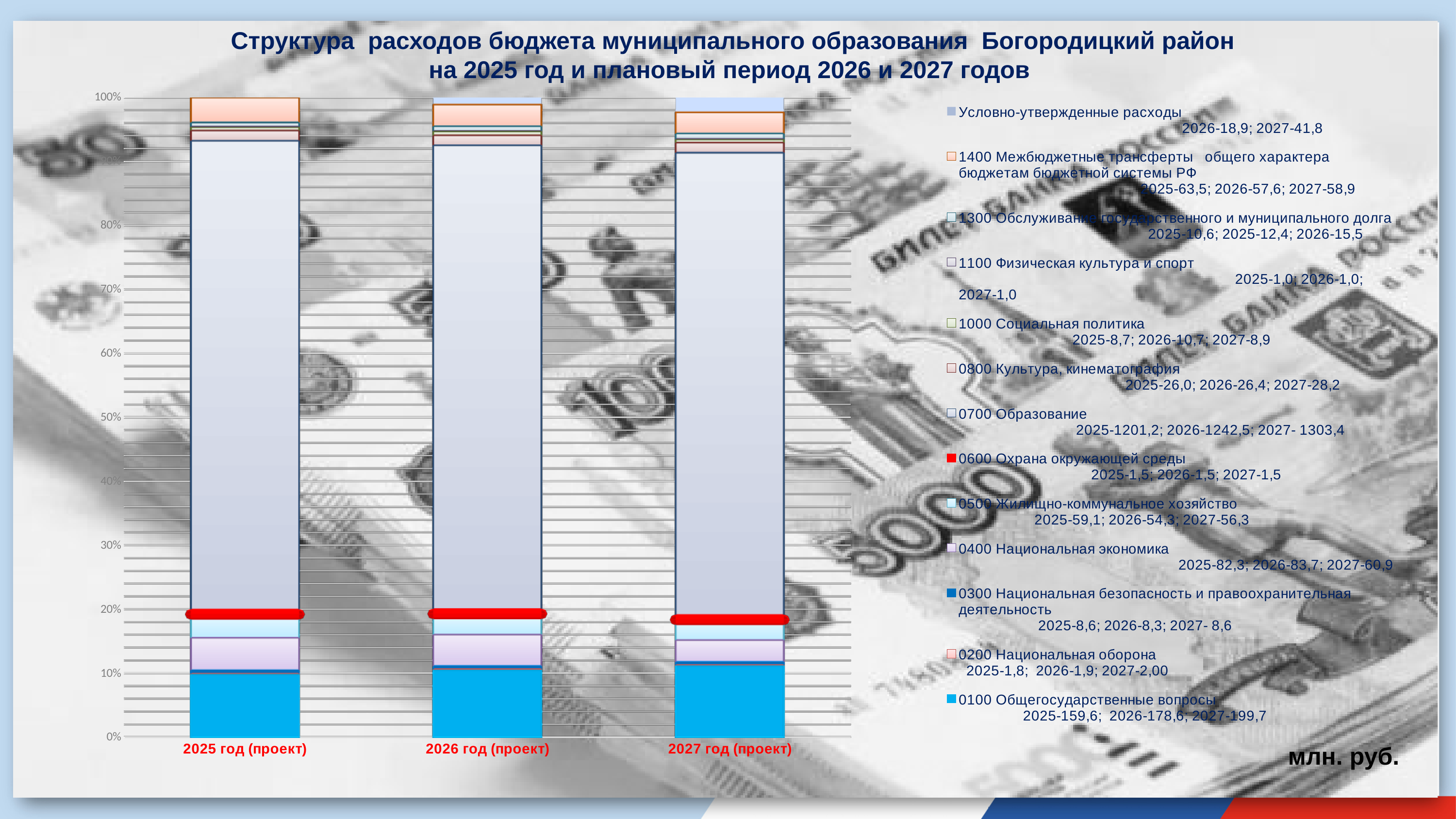
Does the value for 0100 Общегосударственные вопросы rise or fall from 2025 to 2027? Rise How many series does the legend list? 13 Is the share of 0700 Образование in the 2025 bar greater or less than 50%? greater According to the legend, what is the value for 0100 Общегосударственные вопросы in 2027? 199,7 Which is larger: the value for 0500 Жилищно-коммунальное хозяйство in 2025 or in 2026? 2025 According to the legend, what is the value for Условно-утвержденные расходы in 2026? 18,9 According to the legend, what is the value for 0700 Образование in 2025? 1201,2 How many bars (years) are plotted on the chart? 3 By how much does the value for 0700 Образование in 2027 exceed its value in 2026? 60,9 What unit of measurement is indicated in the bottom right corner of the slide? млн. руб. What kind of chart is shown on the slide? Stacked bar chart According to the legend, what is the value for 0400 Национальная экономика in 2027? 60,9